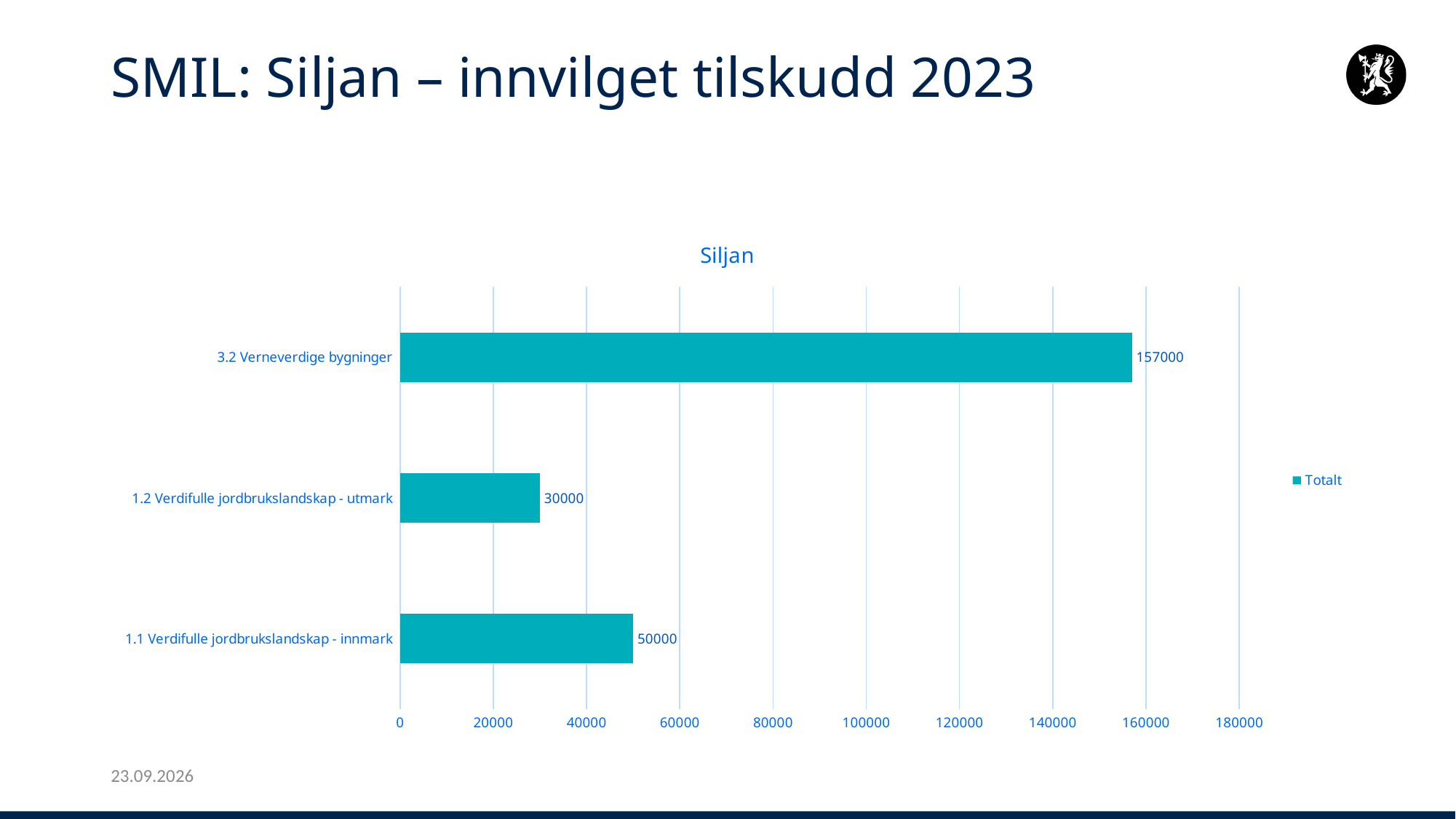
What is the value for 3.2 Verneverdige bygninger? 157000 What is the name of the series listed in the legend? Totalt What is the difference between the values for 1.1 Verdifulle jordbrukslandskap - innmark and 1.2 Verdifulle jordbrukslandskap - utmark? 20000 How many categories are shown in the chart? 3 What kind of chart is shown on the slide? Bar chart Which category has the lowest value? 1.2 Verdifulle jordbrukslandskap - utmark What is the value for 1.1 Verdifulle jordbrukslandskap - innmark? 50000 Which is larger, the value for 1.1 Verdifulle jordbrukslandskap - innmark or 1.2 Verdifulle jordbrukslandskap - utmark? 1.1 Verdifulle jordbrukslandskap - innmark What is the value for 1.2 Verdifulle jordbrukslandskap - utmark? 30000 What is the difference between the values for 3.2 Verneverdige bygninger and 1.1 Verdifulle jordbrukslandskap - innmark? 107000 Is the value for 3.2 Verneverdige bygninger greater or less than 140000? greater Which category has the highest value? 3.2 Verneverdige bygninger